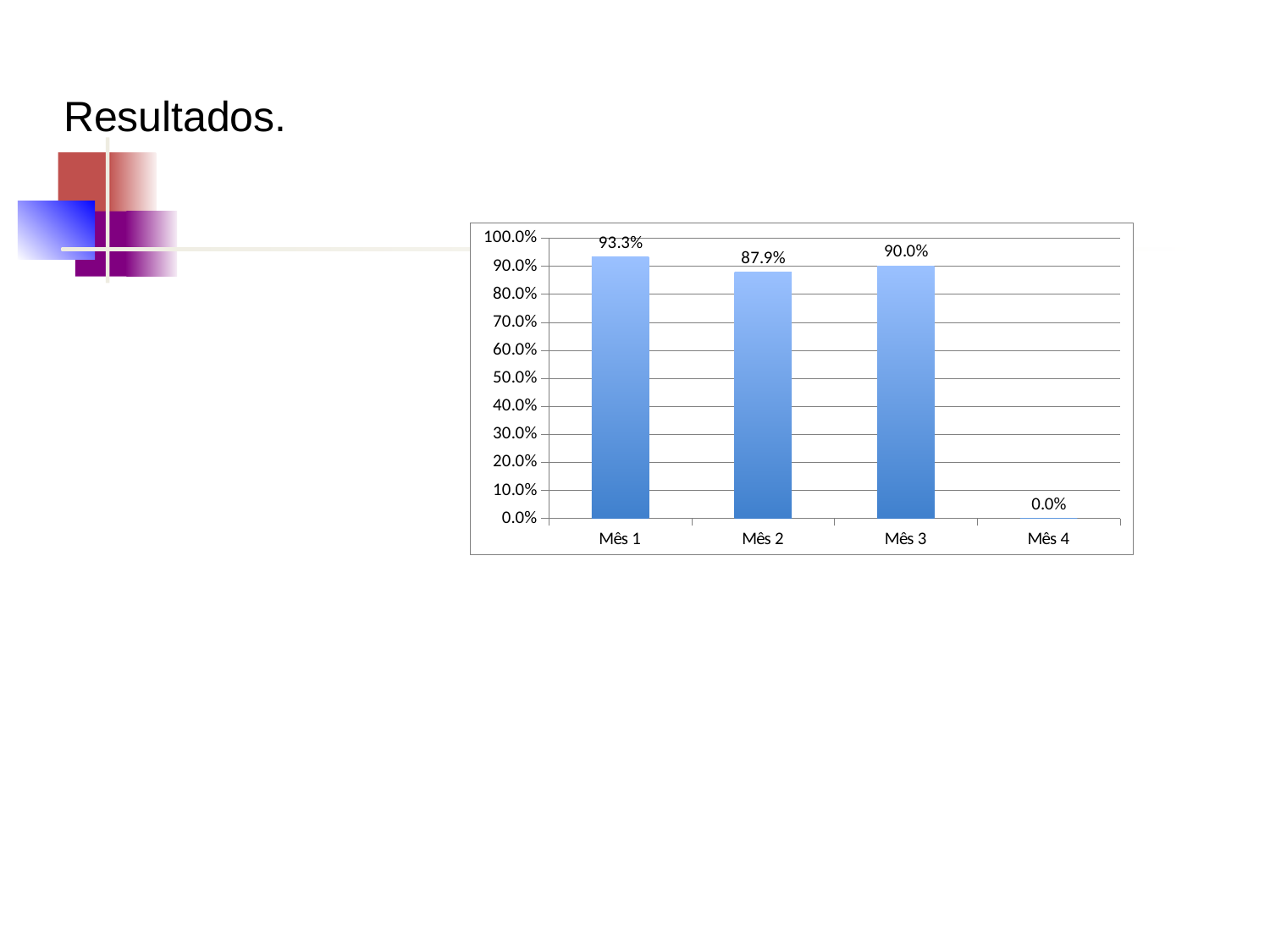
Is the value for Mês 2 greater or less than 90.0%? less What is the difference between the values for Mês 1 and Mês 2? 5.4% Which category has the highest value? Mês 1 What is the value for Mês 1? 93.3% What is the difference between the values for Mês 3 and Mês 2? 2.1% What is the value for Mês 3? 90.0% How many categories are shown on the x axis? 4 What is the value for Mês 4? 0.0% What kind of chart is shown on the slide? bar chart Which category has the lowest value? Mês 4 What is the value for Mês 2? 87.9% Which is larger, the value for Mês 2 or the value for Mês 3? Mês 3